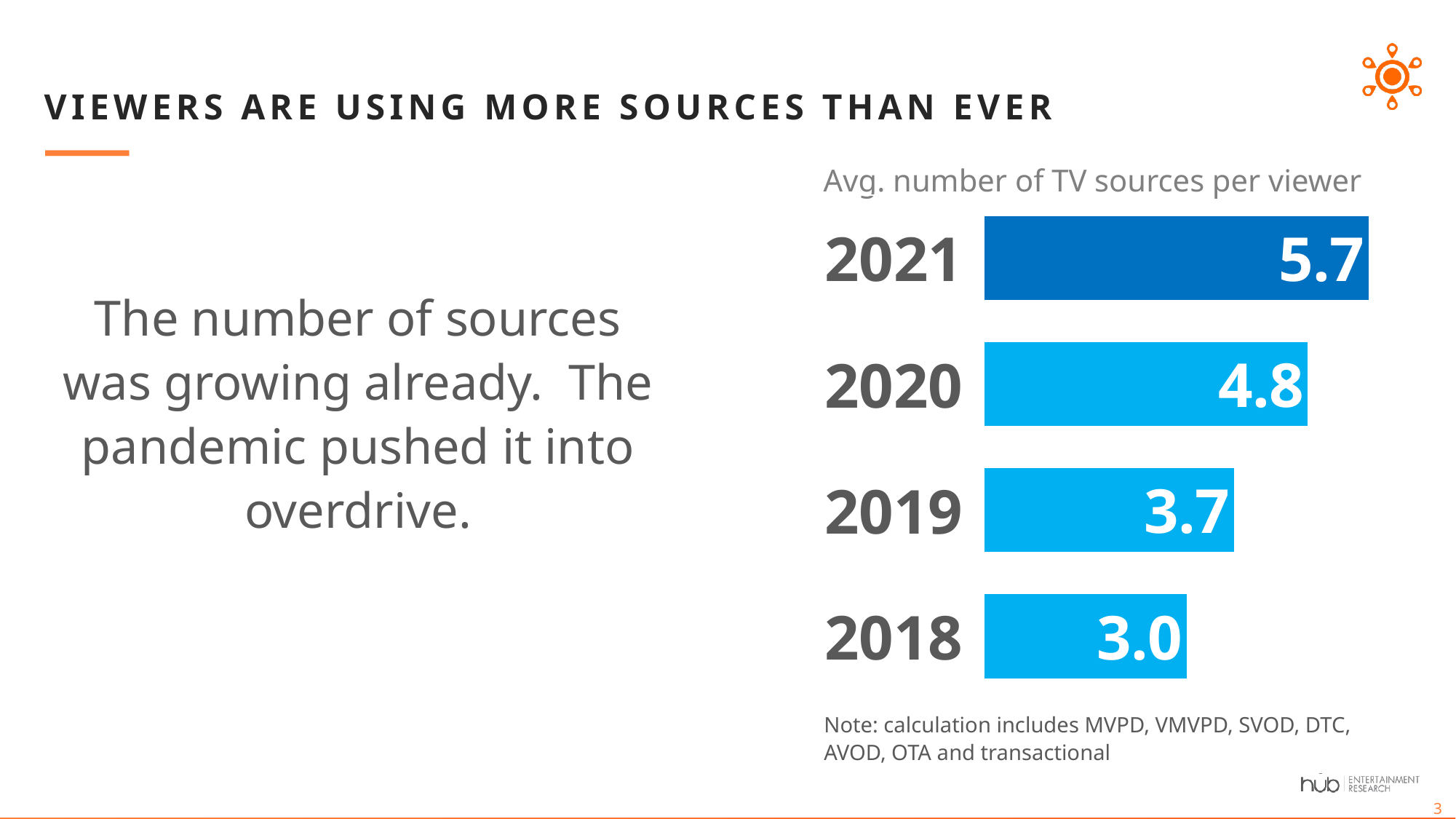
Does the average number of TV sources per viewer rise or fall from 2018 to 2021? Rise Which year has a larger value, 2019 or 2020? 2020 What kind of chart is shown on the slide? Bar chart What is the difference between the 2021 and 2020 values? 0.9 What is the title of the chart? Avg. number of TV sources per viewer What is the difference between the 2021 and 2018 values? 2.7 Which year has the lowest average number of TV sources per viewer? 2018 Which year has the highest average number of TV sources per viewer? 2021 What is the average number of TV sources per viewer in 2018? 3.0 What is the average number of TV sources per viewer in 2019? 3.7 How many years are shown in the chart? 4 What is the average number of TV sources per viewer in 2021? 5.7